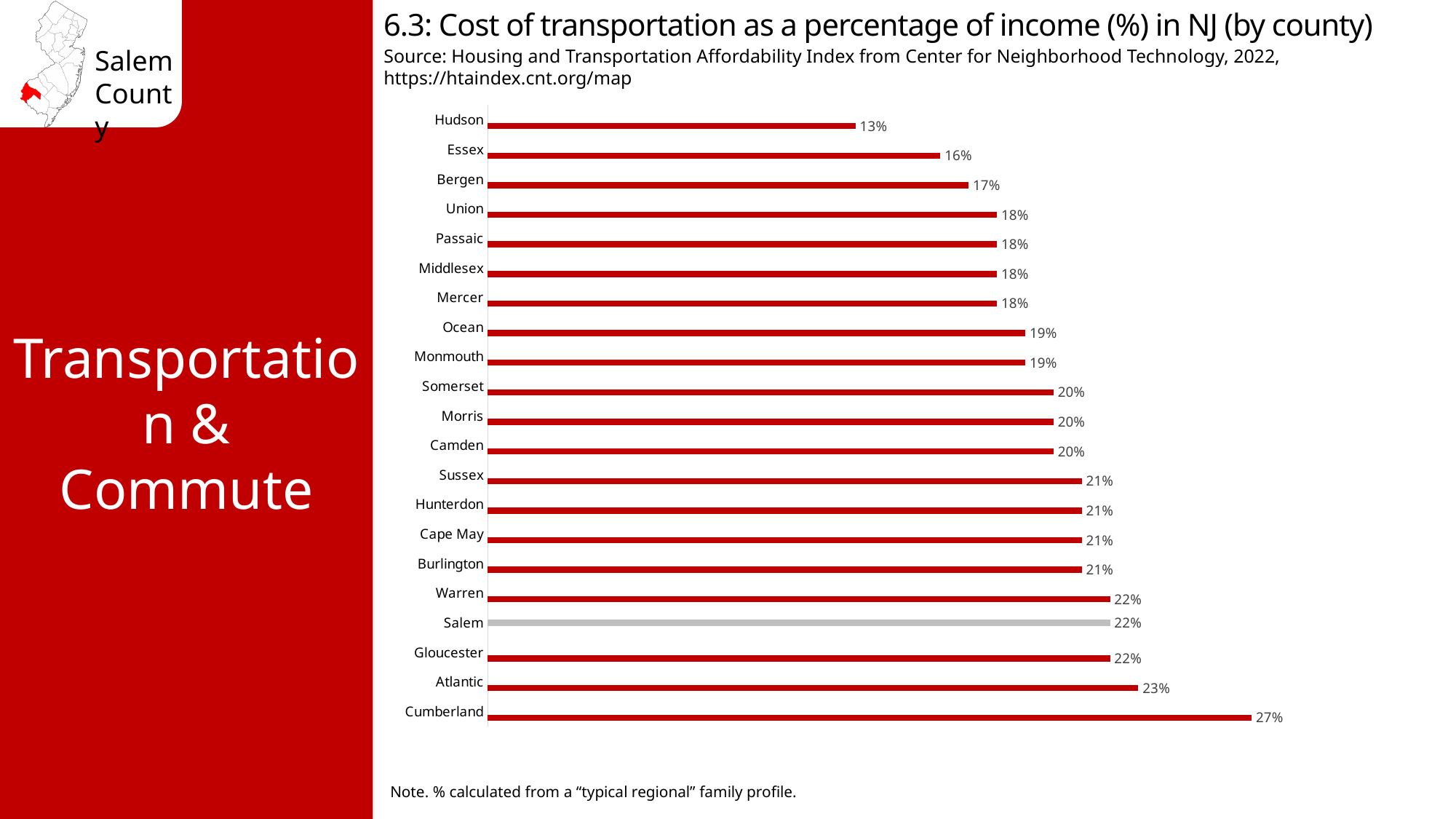
What is the difference in percentage points between Salem and Essex? 6 What is the value shown for Atlantic County? 23% What is the cost of transportation as a percentage of income for Salem County? 22% How many counties are shown in the chart? 21 What is the value shown for Cumberland County? 27% Which county has a higher value, Atlantic or Bergen? Atlantic Which county has the lowest cost of transportation as a percentage of income? Hudson What is the cost of transportation as a percentage of income for Hudson County? 13% What is the difference in percentage points between Cumberland and Hudson? 14 Which county has the highest cost of transportation as a percentage of income? Cumberland Which county's bar is shown in grey instead of red? Salem What type of chart is used on this slide? Bar chart